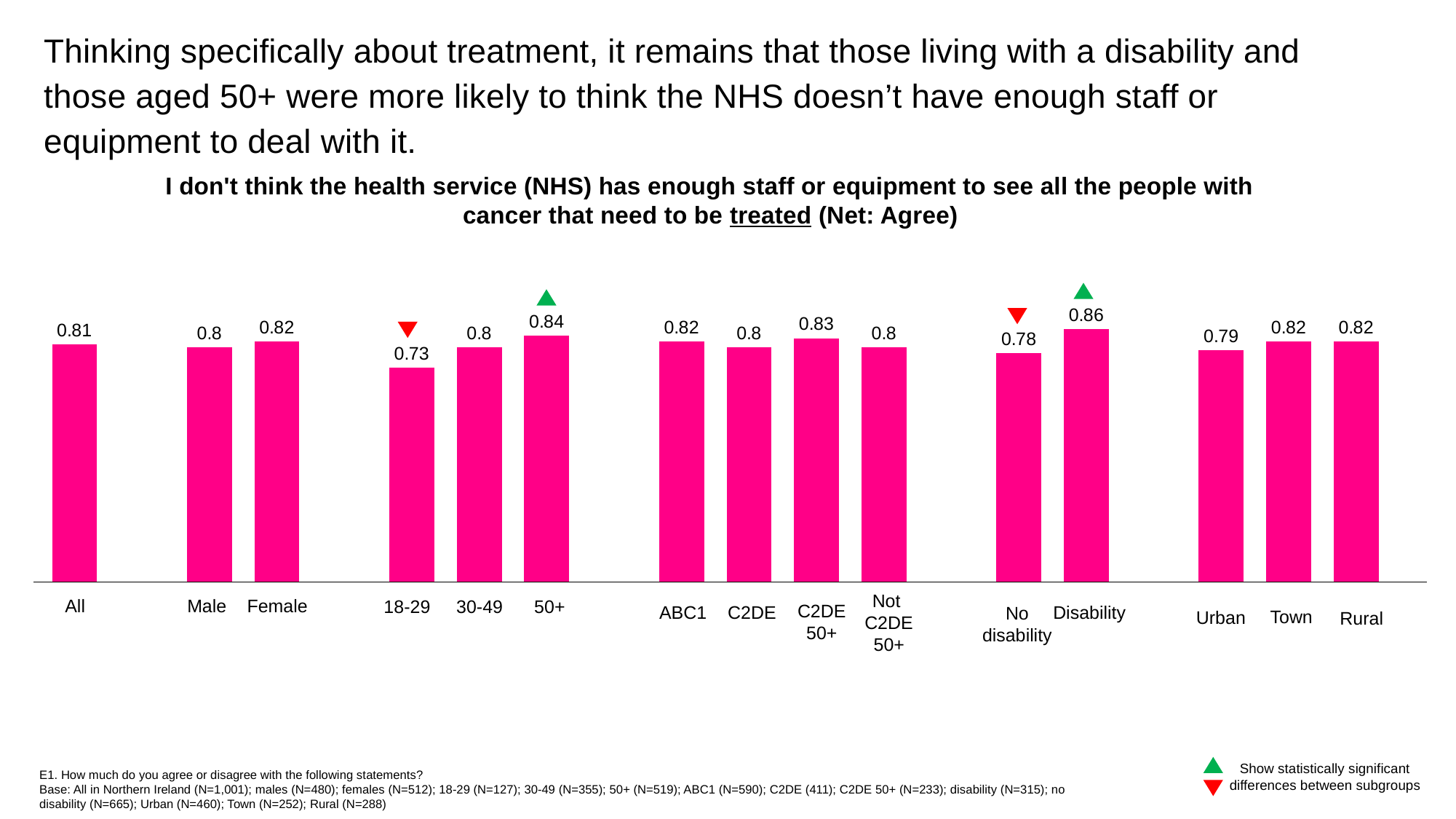
Which category has the highest value? Disability What is the value for the Urban category? 0.79 Which is larger, the value for Female or the value for Male? Female What kind of chart is shown on the slide? Bar chart What is the difference between the values for Disability and No disability? 0.08 What is the value for the Disability group? 0.86 What is the value for the 18-29 age group? 0.73 Which category has the lowest value? 18-29 How many categories (bars) are shown in the chart? 15 What is the difference between the values for 50+ and 18-29? 0.11 What colour are the bars in the chart? Pink What is the value for the 'All' category? 0.81